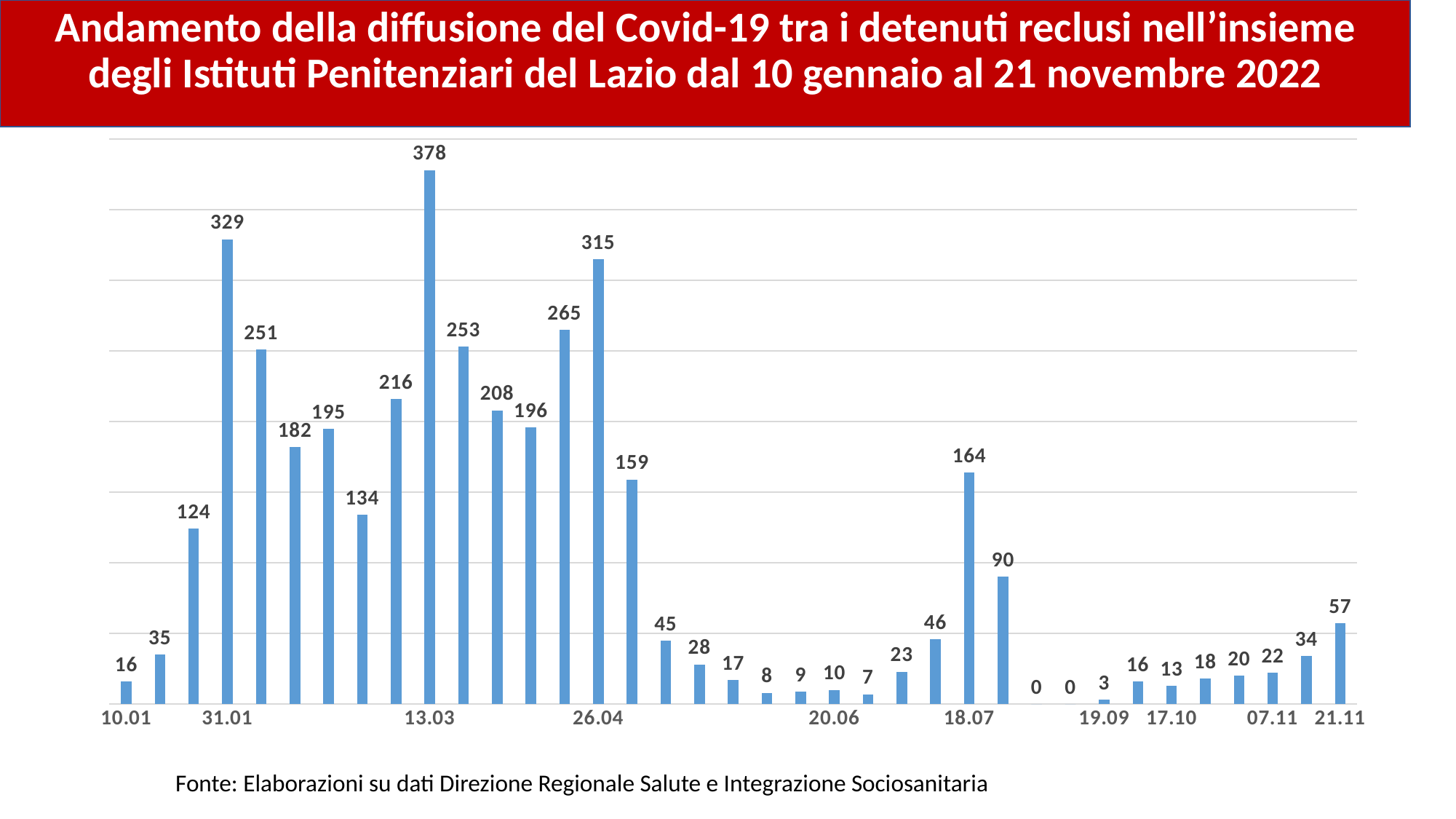
How many bars are plotted in the chart? 37 What is the source cited below the chart? Elaborazioni su dati Direzione Regionale Salute e Integrazione Sociosanitaria What is the value for 13.03? 378 What is the difference between the values for 13.03 and 26.04? 63 What kind of chart is shown on the slide? Bar chart Which date has the highest value? 13.03 What is the difference between the values for 07.11 and 17.10? 9 What is the value for 10.01? 16 What is the value for 18.07? 164 Which is larger, the value for 18.07 or the value for 21.11? 18.07 What is the value for 31.01? 329 What is the value for 21.11? 57